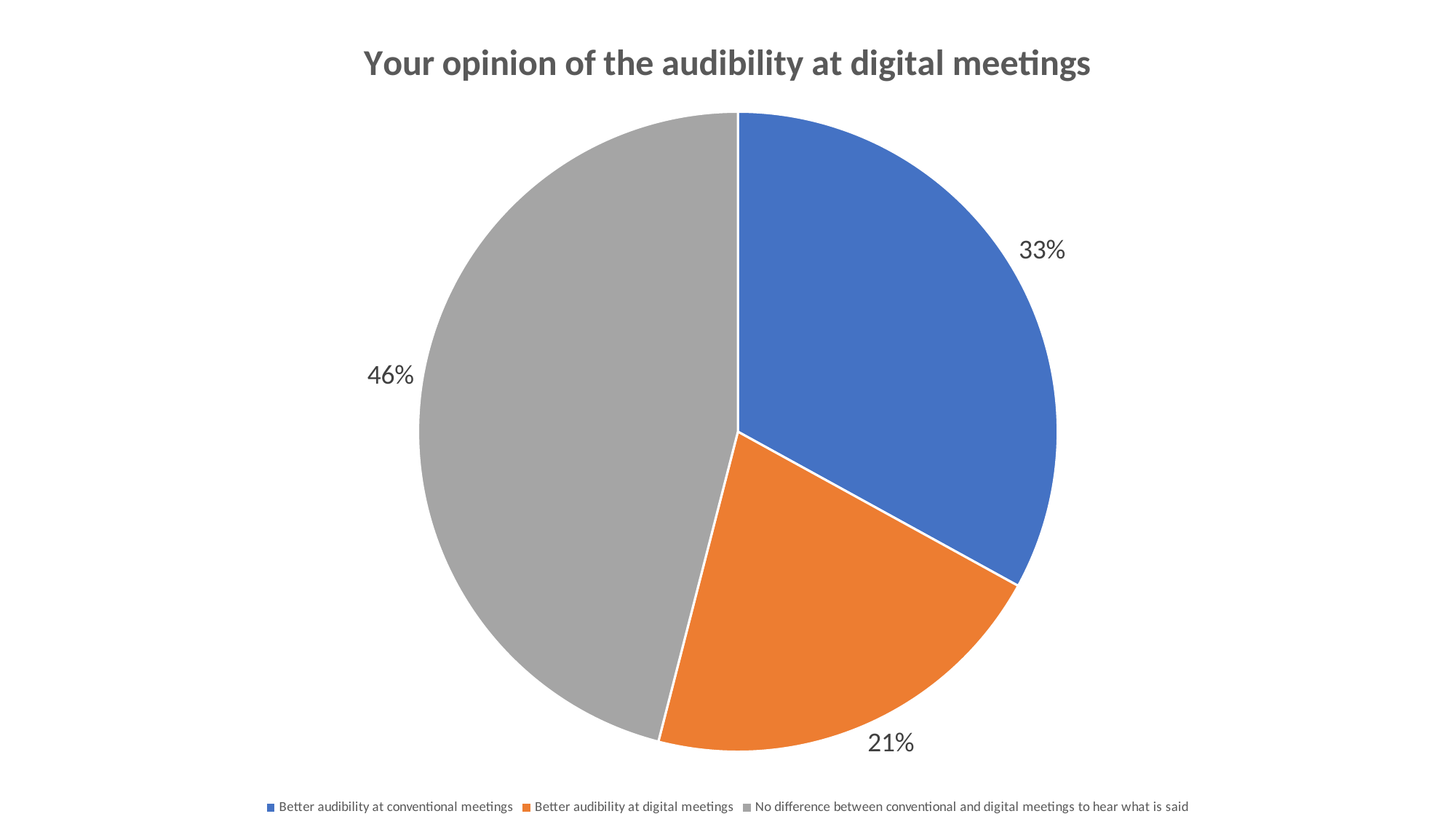
How many percentage points larger is the 'No difference' slice than the 'Better audibility at digital meetings' slice? 25 How many slices does the pie chart have? 3 What percentage of respondents said there is better audibility at conventional meetings? 33% Which response has the largest share of the pie? No difference between conventional and digital meetings to hear what is said What kind of chart is shown on the slide? Pie chart What is the difference in percentage points between 'Better audibility at conventional meetings' and 'Better audibility at digital meetings'? 12 What colour is the slice for 'Better audibility at digital meetings'? Orange What percentage of respondents said there is no difference between conventional and digital meetings to hear what is said? 46% Which is larger: the share for 'Better audibility at conventional meetings' or the share for 'Better audibility at digital meetings'? Better audibility at conventional meetings Which response has the smallest share of the pie? Better audibility at digital meetings What is the title of the chart? Your opinion of the audibility at digital meetings What percentage of respondents said there is better audibility at digital meetings? 21%